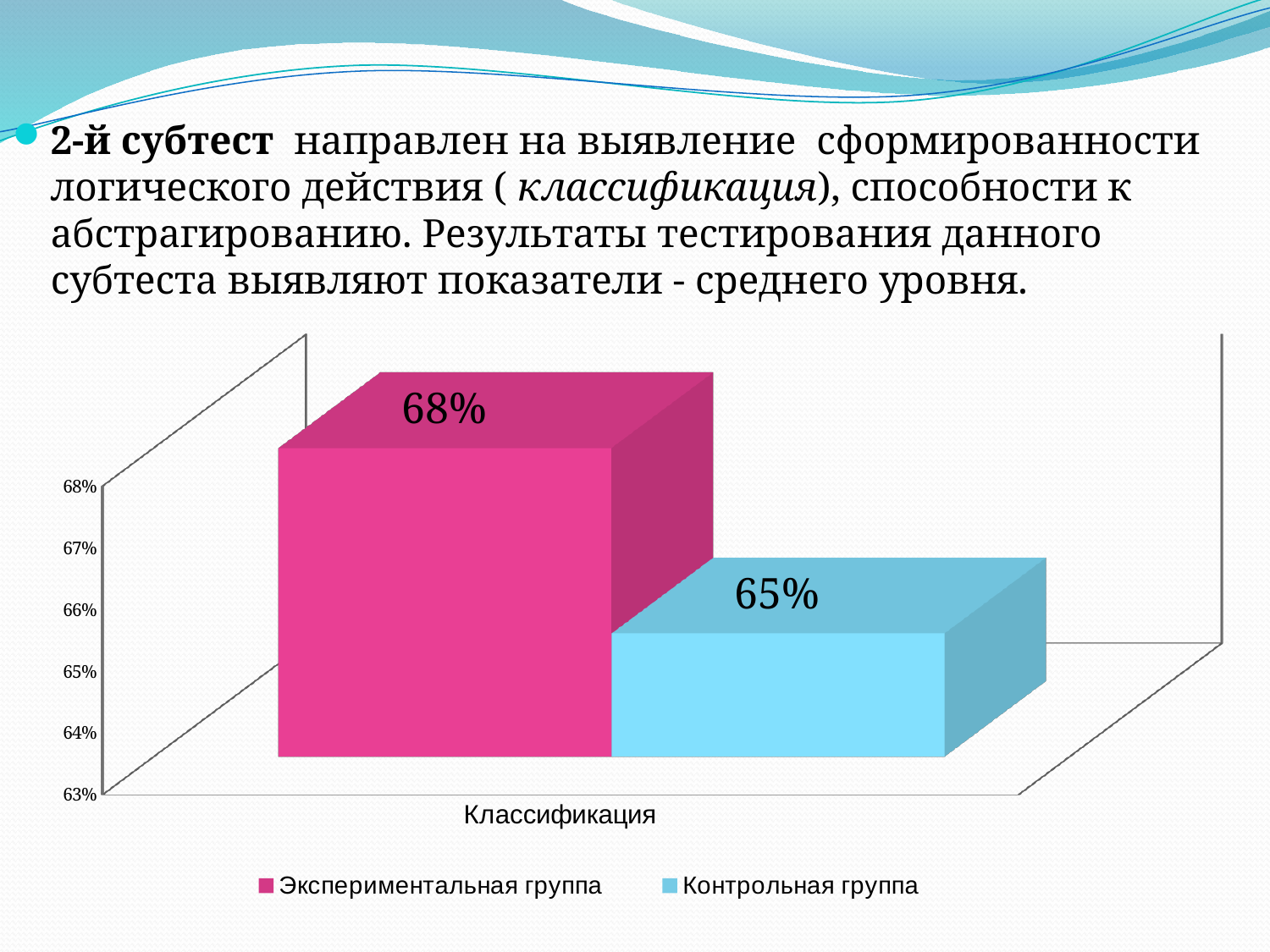
Is the value for Контрольная группа greater or less than 66%? less What is the value for Контрольная группа in the Классификация chart? 65% Which series has the higher value for Классификация? Экспериментальная группа Is the value for Экспериментальная группа greater or less than 67%? greater How many categories are shown on the x axis? 1 How many series does the legend list? 2 What is the difference between the Экспериментальная группа and Контрольная группа values? 3% Which series has the lower value for Классификация? Контрольная группа Is the value for Экспериментальная группа larger or smaller than the value for Контрольная группа? larger What colour is the bar for Контрольная группа? light blue What kind of chart is shown on the slide? bar chart What is the value for Экспериментальная группа in the Классификация chart? 68%